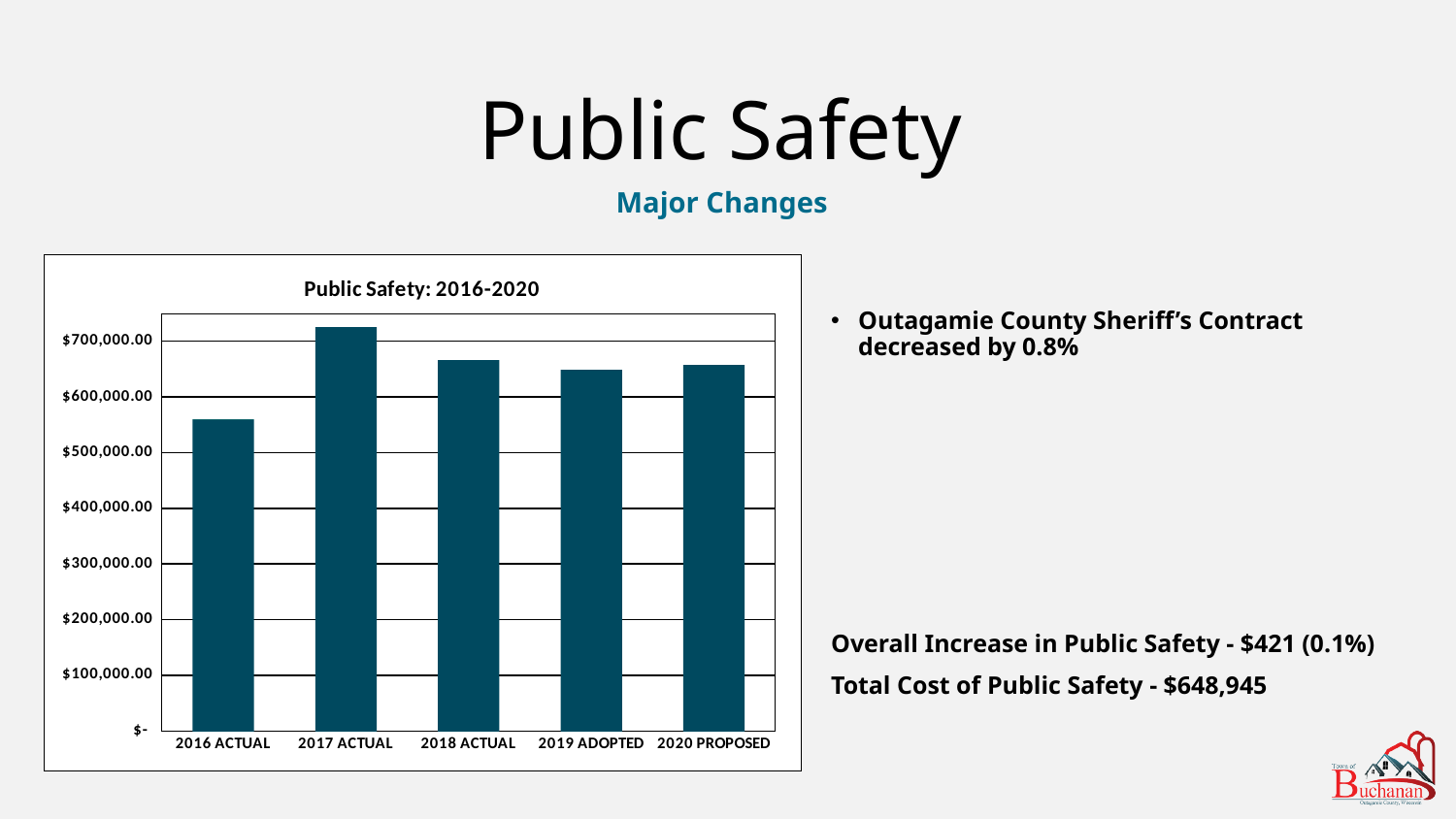
What is the title of the chart on the slide? Public Safety: 2016-2020 Which category has the highest value in the chart? 2017 ACTUAL Is the value for 2019 ADOPTED greater or less than $600,000.00? greater Is the value for 2017 ACTUAL greater or less than $700,000.00? greater Which category has the lowest value in the chart? 2016 ACTUAL Which is larger, the value for 2017 ACTUAL or the value for 2018 ACTUAL? 2017 ACTUAL Is the value for 2016 ACTUAL greater or less than $600,000.00? less What type of chart is shown on the slide? Bar chart How many categories are shown on the x axis of the chart? 5 Which is larger, the value for 2016 ACTUAL or the value for 2020 PROPOSED? 2020 PROPOSED